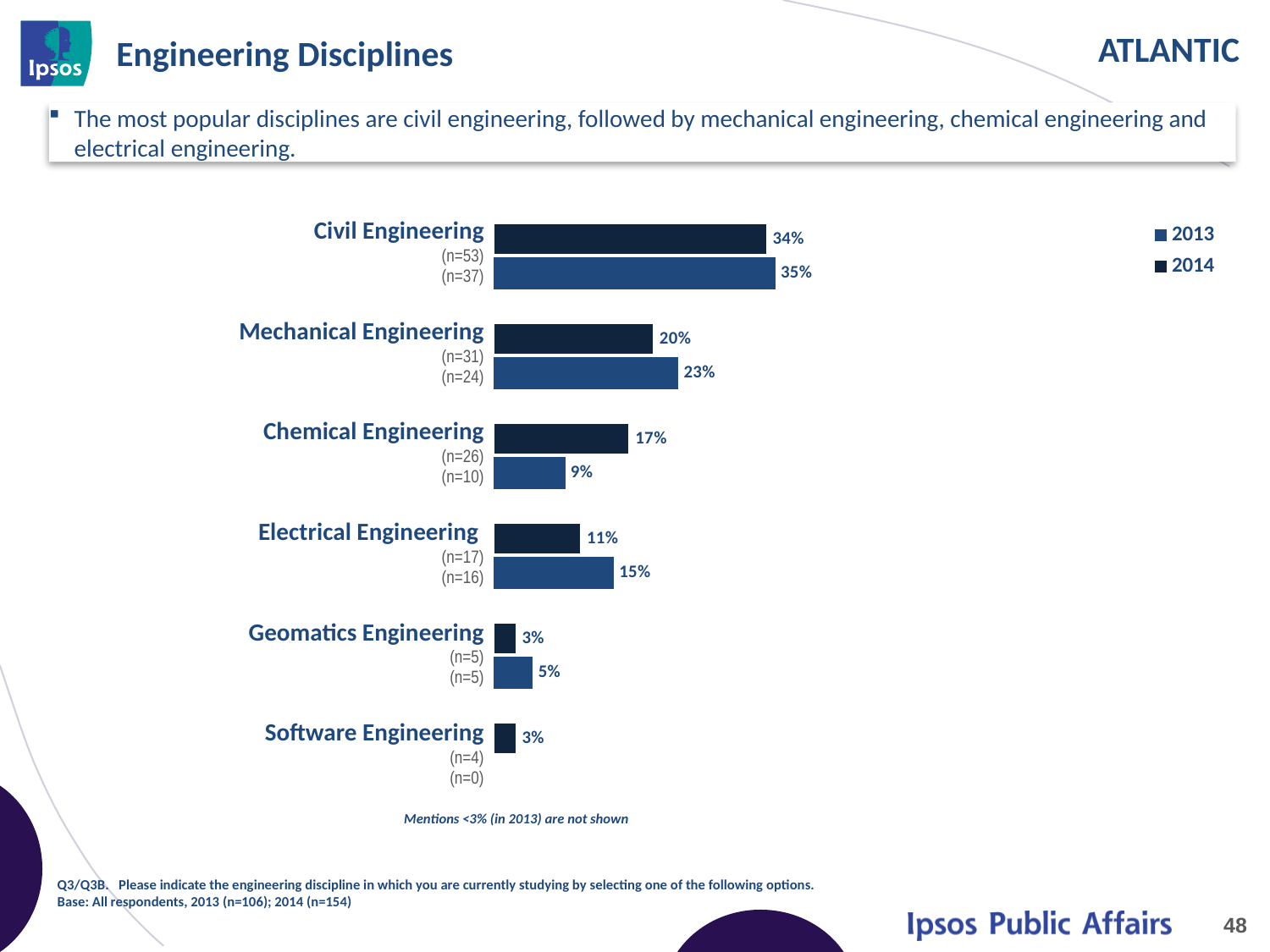
What is the 2014 value for Civil Engineering? 35% What kind of chart is shown on the slide? Bar chart What is the 2014 value for Electrical Engineering? 15% Which is larger for Chemical Engineering, the 2013 value or the 2014 value? 2013 What is the difference between the 2014 values for Civil Engineering and Mechanical Engineering? 12% Which discipline has the highest 2013 value? Civil Engineering What is the 2013 value for Chemical Engineering? 17% Which is larger for Mechanical Engineering, the 2013 value or the 2014 value? 2014 How many engineering disciplines are listed on the chart? 6 What is the difference between the 2013 and 2014 values for Chemical Engineering? 8% Which discipline has the lowest 2014 value among those with a 2014 bar shown? Geomatics Engineering How many series does the legend list? 2